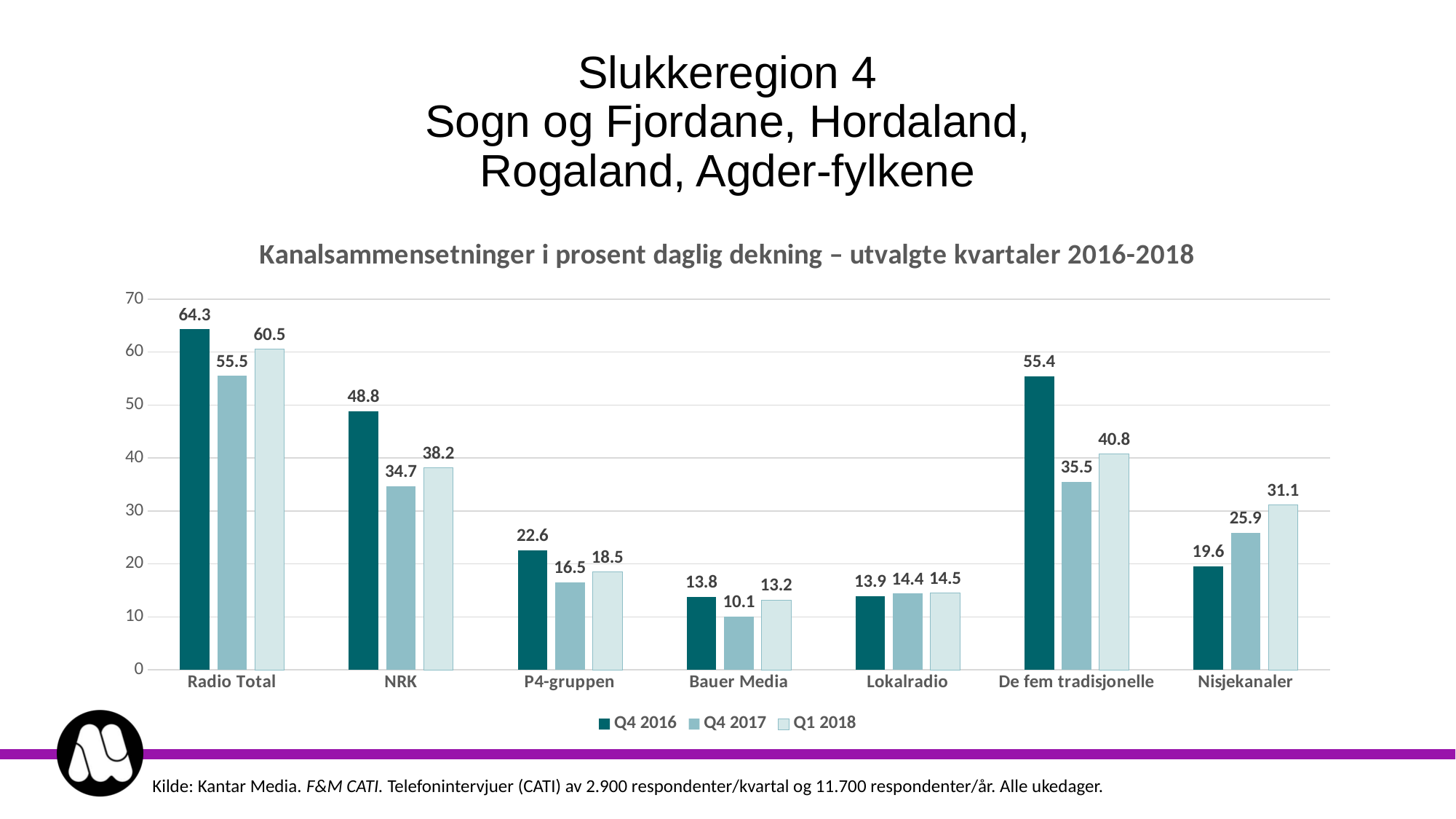
Which category has the lowest Q1 2018 value? Bauer Media What is the Q4 2017 value for Bauer Media? 10.1 How many categories are shown on the x axis? 7 Which is larger for Nisjekanaler: the Q4 2017 value or the Q1 2018 value? Q1 2018 How many series does the legend list? 3 What is the Q1 2018 value for NRK? 38.2 Which category has the highest Q4 2016 value? Radio Total What is the Q4 2016 value for Radio Total? 64.3 What is the difference between the Q4 2016 and Q1 2018 values for De fem tradisjonelle? 14.6 Do the values for Lokalradio rise or fall from Q4 2016 to Q1 2018? Rise What kind of chart is shown on the slide? Bar chart What is the title of the chart? Kanalsammensetninger i prosent daglig dekning – utvalgte kvartaler 2016-2018